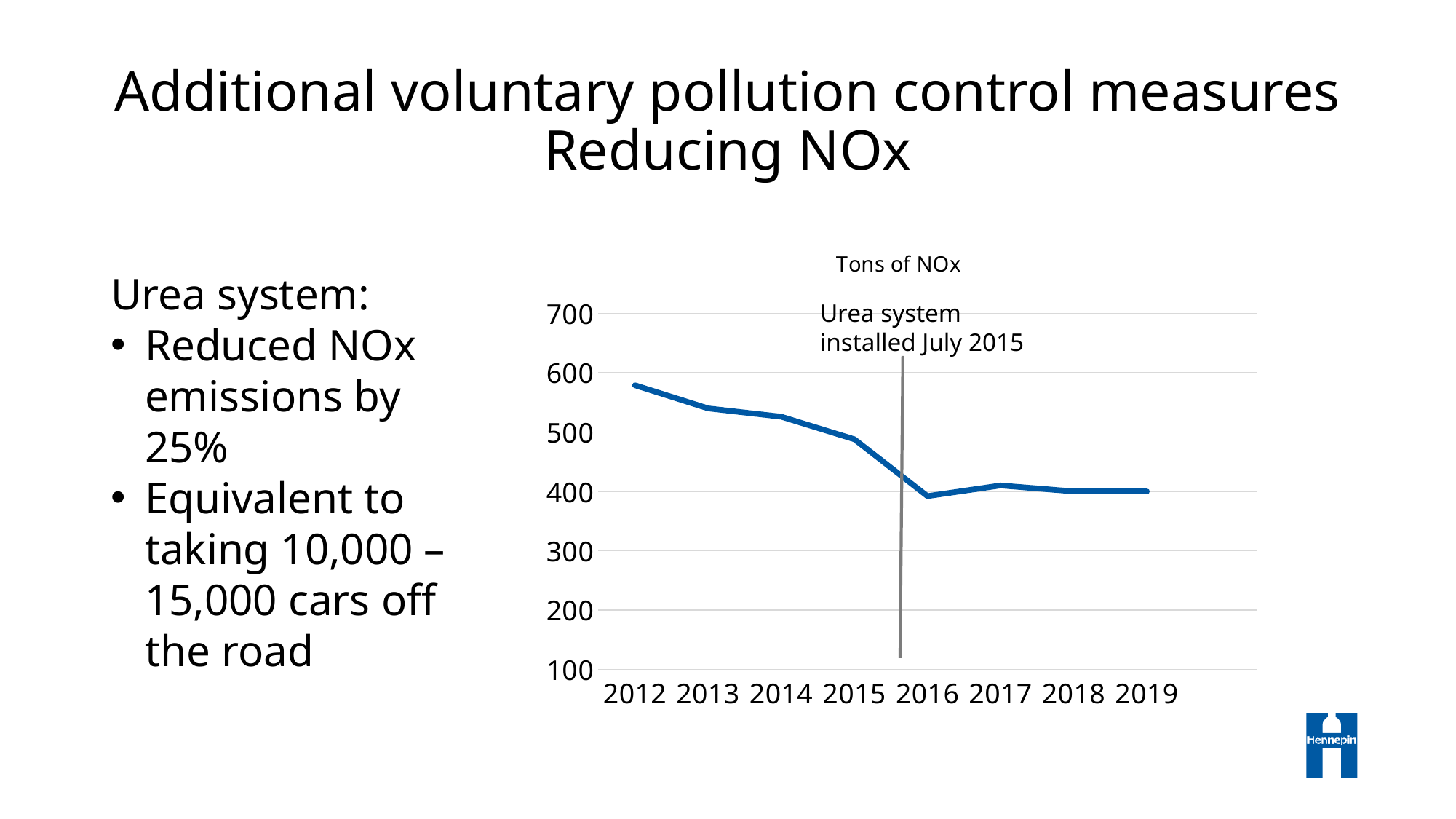
What is the title of the chart? Tons of NOx Do the values generally rise or fall from 2012 to 2019? fall Is the value for 2015 greater or less than 400? greater What kind of chart is shown on the slide? line chart Is the value for 2012 greater or less than 500? greater Is the value for 2016 greater or less than 500? less Which is larger, the value for 2014 or the value for 2017? 2014 What event does the vertical line annotation on the chart mark? Urea system installed July 2015 Which is larger, the value for 2012 or the value for 2019? 2012 How many years are plotted on the x axis of the chart? 8 Which year has the highest value in the chart? 2012